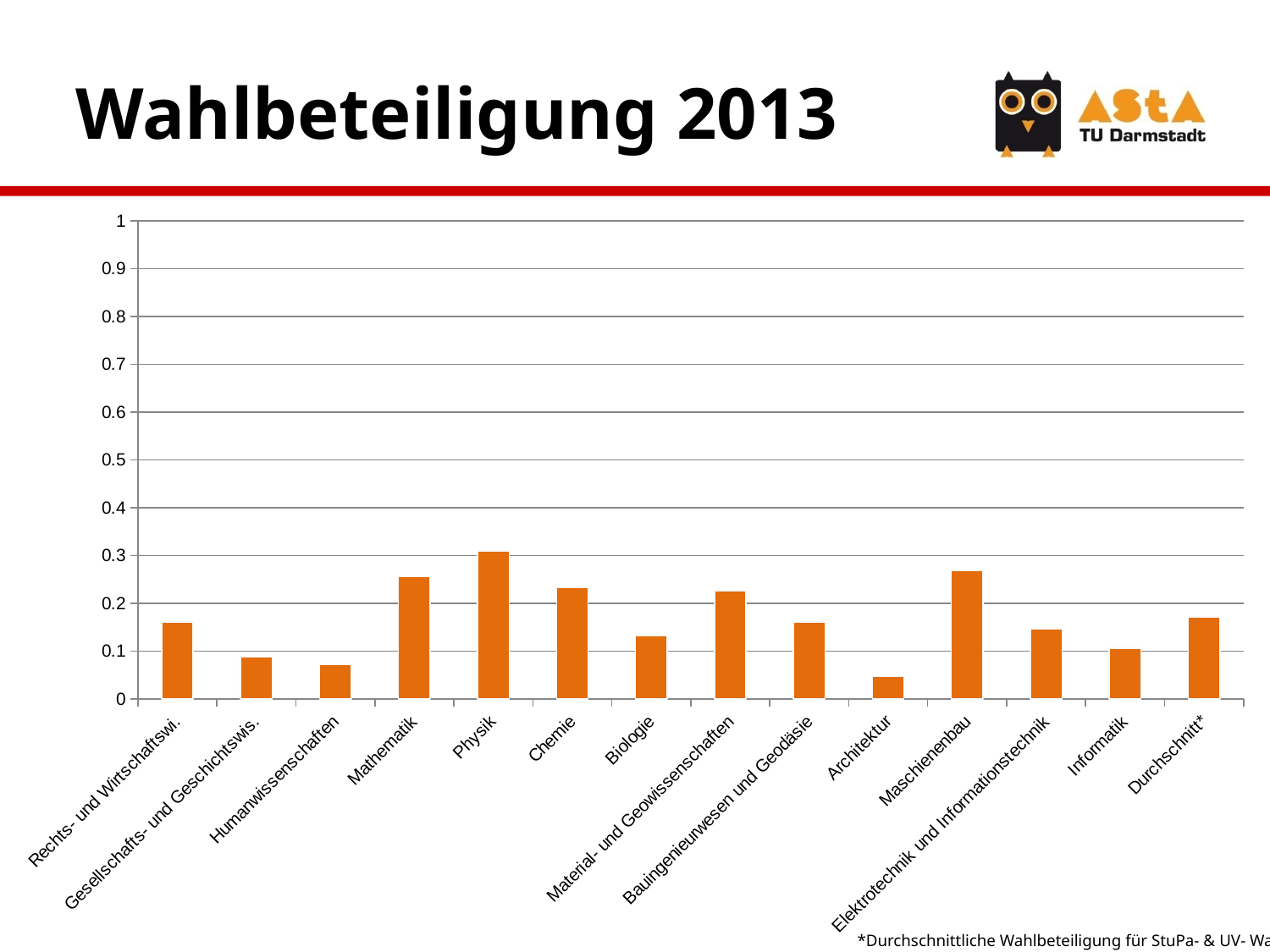
Is the value for Biologie greater or less than 0.1? greater Which is larger, the value for Biologie or the value for Informatik? Biologie Is the value for Mathematik greater or less than 0.2? greater Which category has the lowest value in the chart? Architektur Which is larger, the value for Physik or the value for Maschienenbau? Physik Is the value for Architektur greater or less than 0.1? less How many categories are shown on the x axis of the chart? 14 Which category has the highest value in the chart? Physik What is the title of the slide containing the chart? Wahlbeteiligung 2013 What kind of chart is shown on the slide? bar chart